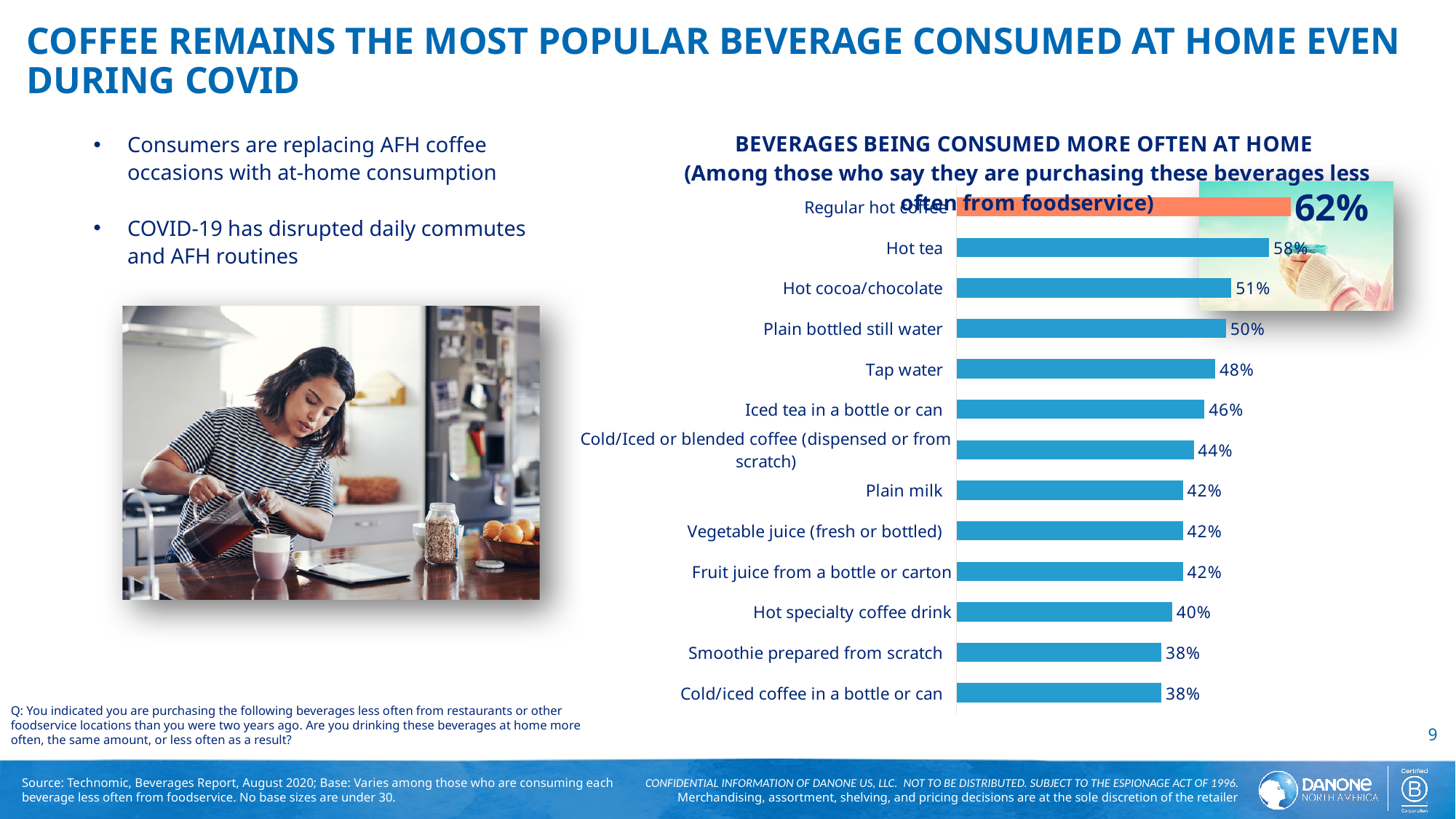
Which bar in the chart is coloured orange rather than blue? Regular hot coffee Which has a larger value, Hot specialty coffee drink or Plain milk? Plain milk What type of chart is used on this slide? Bar chart What is the difference between the values for Regular hot coffee and Hot tea? 4% What percentage is shown for Smoothie prepared from scratch? 38% What is the difference between the values for Hot cocoa/chocolate and Hot specialty coffee drink? 11% What value is shown for Tap water? 48% Which beverage has the highest value in the chart? Regular hot coffee Which has a larger value, Plain bottled still water or Iced tea in a bottle or can? Plain bottled still water How many beverage categories are shown in the chart? 13 What value is shown for Cold/Iced or blended coffee (dispensed or from scratch)? 44% What percentage is shown for Hot tea? 58%